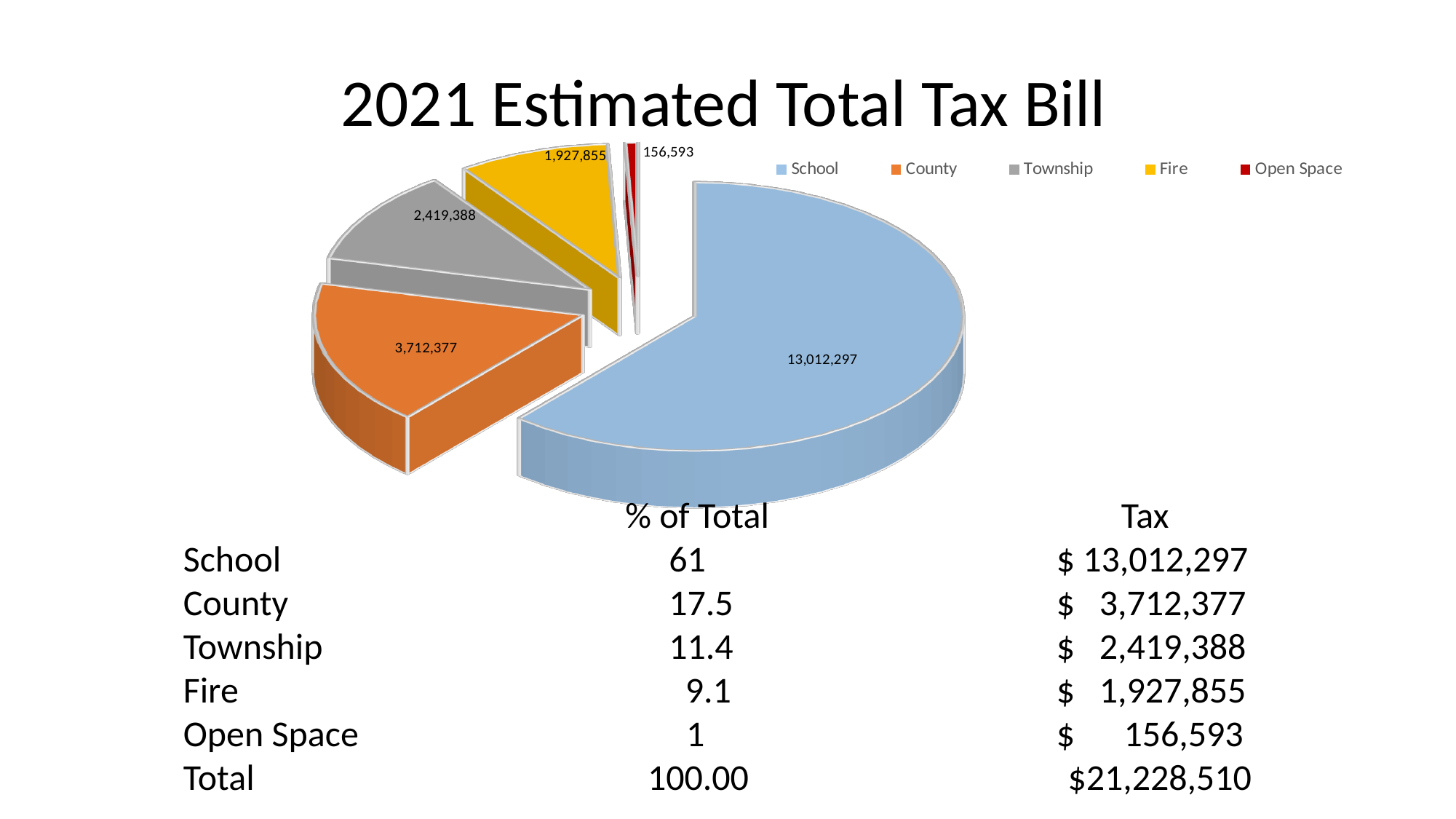
Which category has the smallest slice in the pie chart? Open Space What is the value of the Open Space slice in the pie chart? 156,593 Which is larger in the pie chart, the Township slice or the Fire slice? Township What is the difference between the School and County values in the pie chart? 9,299,920 How many slices does the pie chart have? 5 What is the value of the School slice in the pie chart? 13,012,297 What is the value of the County slice in the pie chart? 3,712,377 What kind of chart is shown on the slide? pie chart Which category has the largest slice in the pie chart? School What is the value of the Township slice in the pie chart? 2,419,388 What is the value of the Fire slice in the pie chart? 1,927,855 What is the title of the slide containing the pie chart? 2021 Estimated Total Tax Bill